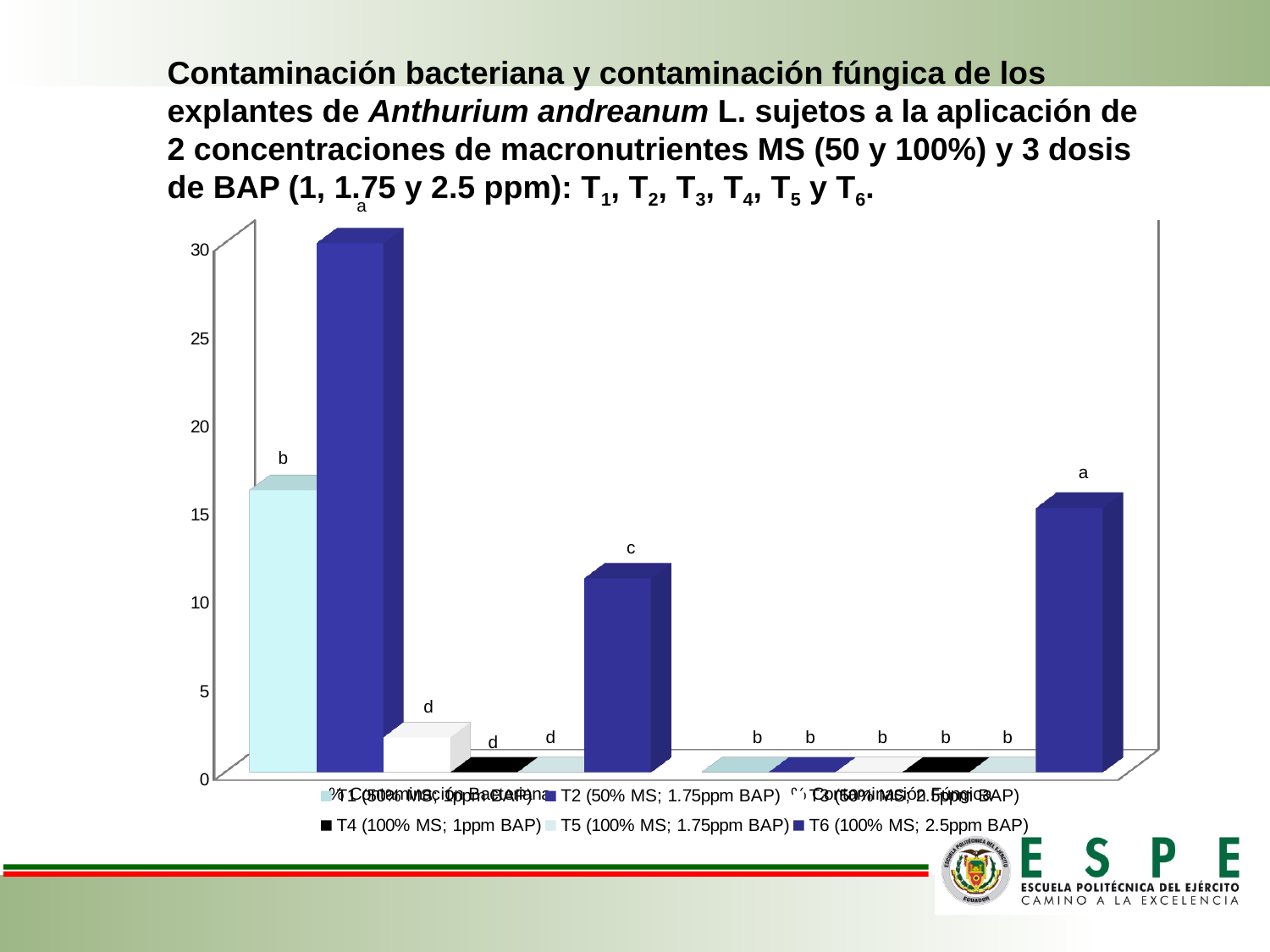
How many series does the legend list? 6 In the right group of bars, which series has the highest bar? T6 (100% MS; 2.5ppm BAP) What kind of chart is shown on the slide? bar chart How many category groups are plotted along the x axis? 2 In the left group of bars, which series has the highest bar? T2 (50% MS; 1.75ppm BAP) What is the highest tick value shown on the vertical axis? 30 Is the value for T6 in the right group greater or less than 10? greater Is the value for T3 in the left group greater or less than 5? less What letter label is printed above the T2 bar in the left group? a Is the value for T2 in the left group greater or less than 25? greater In the left group, which is larger, the bar for T1 or the bar for T2? T2